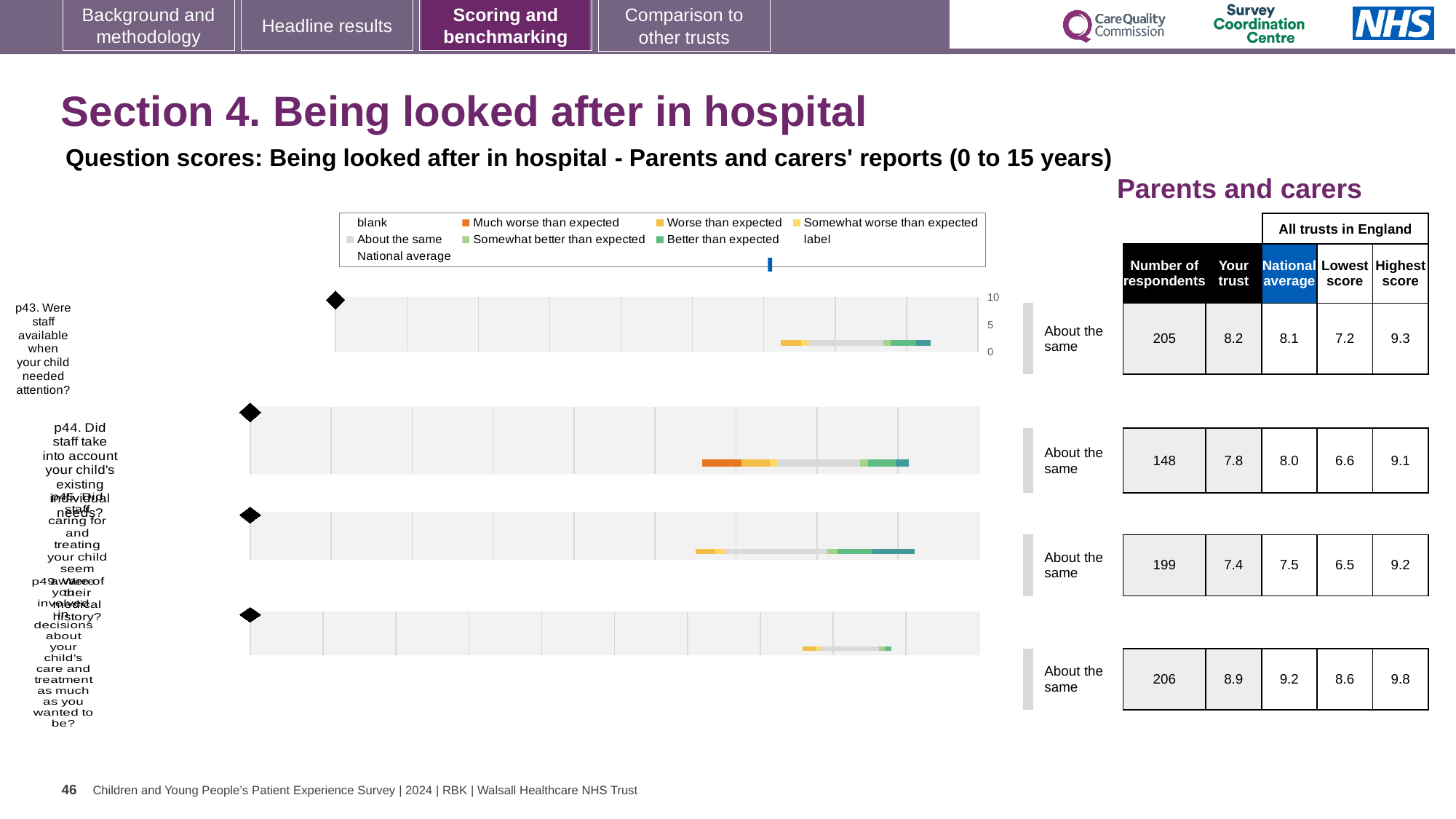
Which row has the highest 'Your trust' score? the fourth row (p49), 8.9 What is the 'Your trust' score for p43 (Were staff available when your child needed attention?)? 8.2 What is the difference between the 'Your trust' score and the national average for p43? 0.1 What is the highest score across all trusts in England for p43? 9.3 For the fourth row (p49), which is larger: the 'Your trust' score or the national average? National average (9.2) What benchmark label is shown for each of the four questions? About the same Which row has the lowest 'Your trust' score? the third row (p45), 7.4 What is the lowest score across all trusts in England for the second row (p44)? 6.6 How many questions (rows) are plotted in the chart? 4 What kind of chart is used to show the question scores on this slide? bar chart How many respondents are listed for p43 (Were staff available when your child needed attention?)? 205 What is the national average for p43 (Were staff available when your child needed attention?)? 8.1